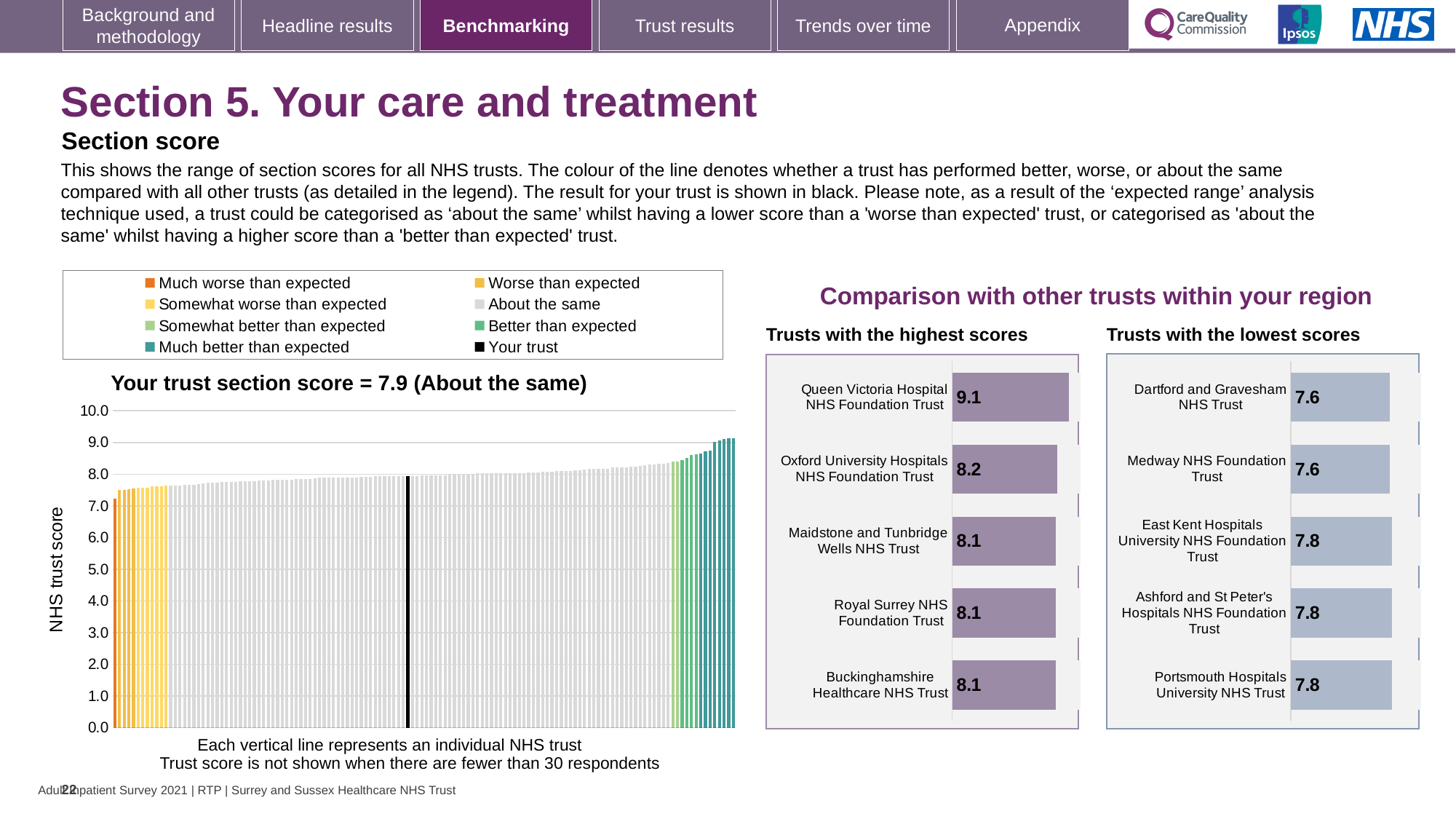
On the 'Your trust section score' chart, what is the section score for your trust? 7.9 How many trusts are shown on the 'Trusts with the lowest scores' chart? 5 What is the y-axis label on the 'Your trust section score' chart? NHS trust score On the 'Trusts with the highest scores' chart, what is the score for Queen Victoria Hospital NHS Foundation Trust? 9.1 On the 'Trusts with the highest scores' chart, which trust has the highest score? Queen Victoria Hospital NHS Foundation Trust On the 'Your trust section score' chart, do the bars rise or fall from left to right along the x axis? rise On the 'Trusts with the lowest scores' chart, what is the score for Medway NHS Foundation Trust? 7.6 How many entries does the legend above the 'Your trust section score' chart list? 8 What kind of chart is the 'Your trust section score' chart? bar chart On the 'Trusts with the lowest scores' chart, which has the larger score: Dartford and Gravesham NHS Trust or Portsmouth Hospitals University NHS Trust? Portsmouth Hospitals University NHS Trust On the 'Trusts with the highest scores' chart, what is the difference between the scores of Queen Victoria Hospital NHS Foundation Trust and Oxford University Hospitals NHS Foundation Trust? 0.9 On the 'Your trust section score' chart, is the value of the tallest bar greater or less than 8.0? greater